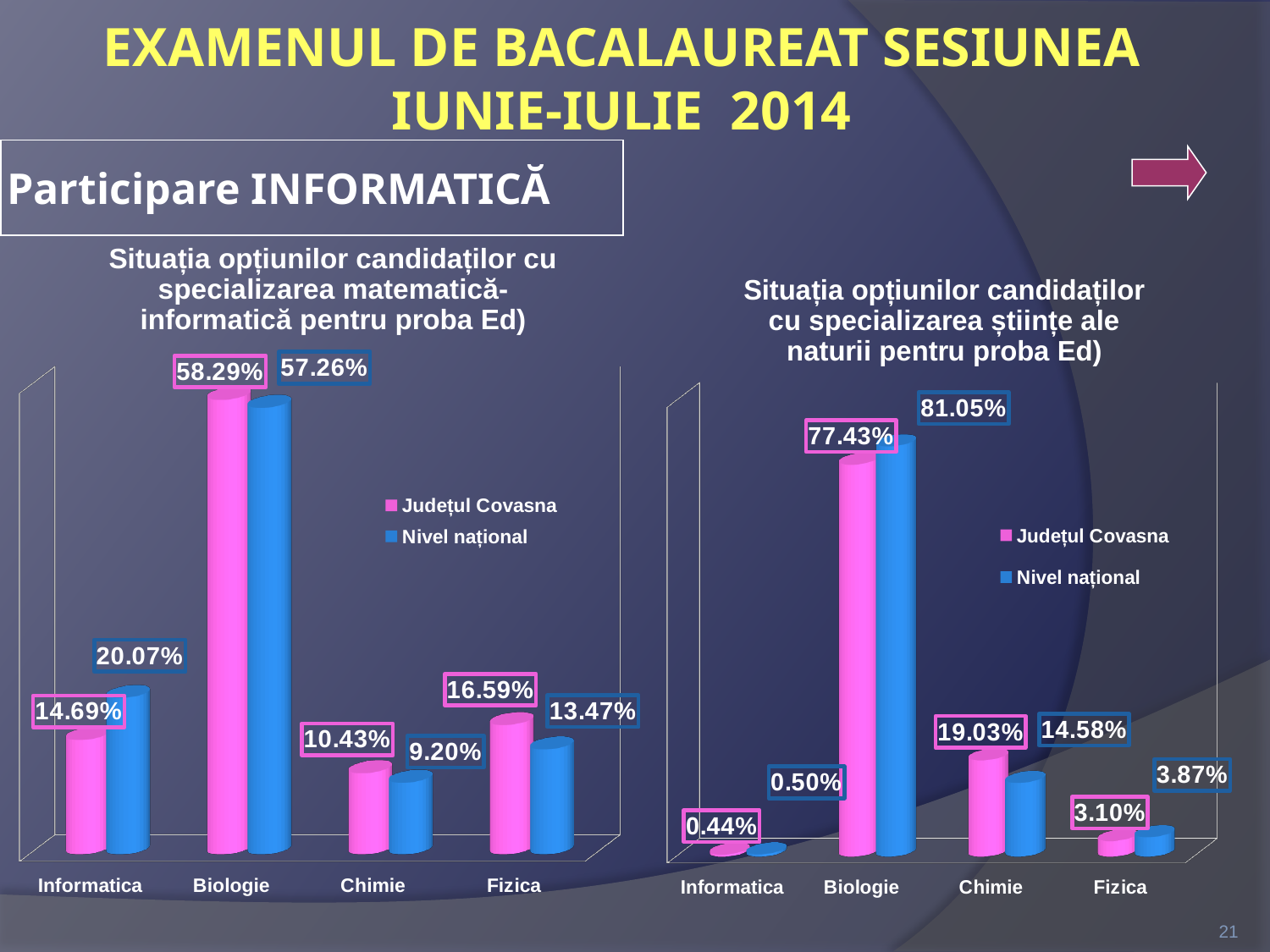
In the right chart, what is the value for Nivel național for Biologie? 81.05% In the left chart, which category has the highest value for Județul Covasna? Biologie In the left chart, what is the value for Județul Covasna for Biologie? 58.29% In the right chart, what is the difference between the Județul Covasna and Nivel național values for Chimie? 4.45% In the left chart, what is the value for Nivel național for Informatica? 20.07% What type of chart is the right chart? Bar chart In the right chart, which category has the lowest value for Nivel național? Informatica In the right chart, what is the value for Județul Covasna for Chimie? 19.03% How many categories are shown on the x axis of the right chart? 4 In the left chart, which is larger for Fizica: Județul Covasna or Nivel național? Județul Covasna How many series does the legend of the left chart list? 2 In the left chart, what is the difference between the Nivel național and Județul Covasna values for Informatica? 5.38%